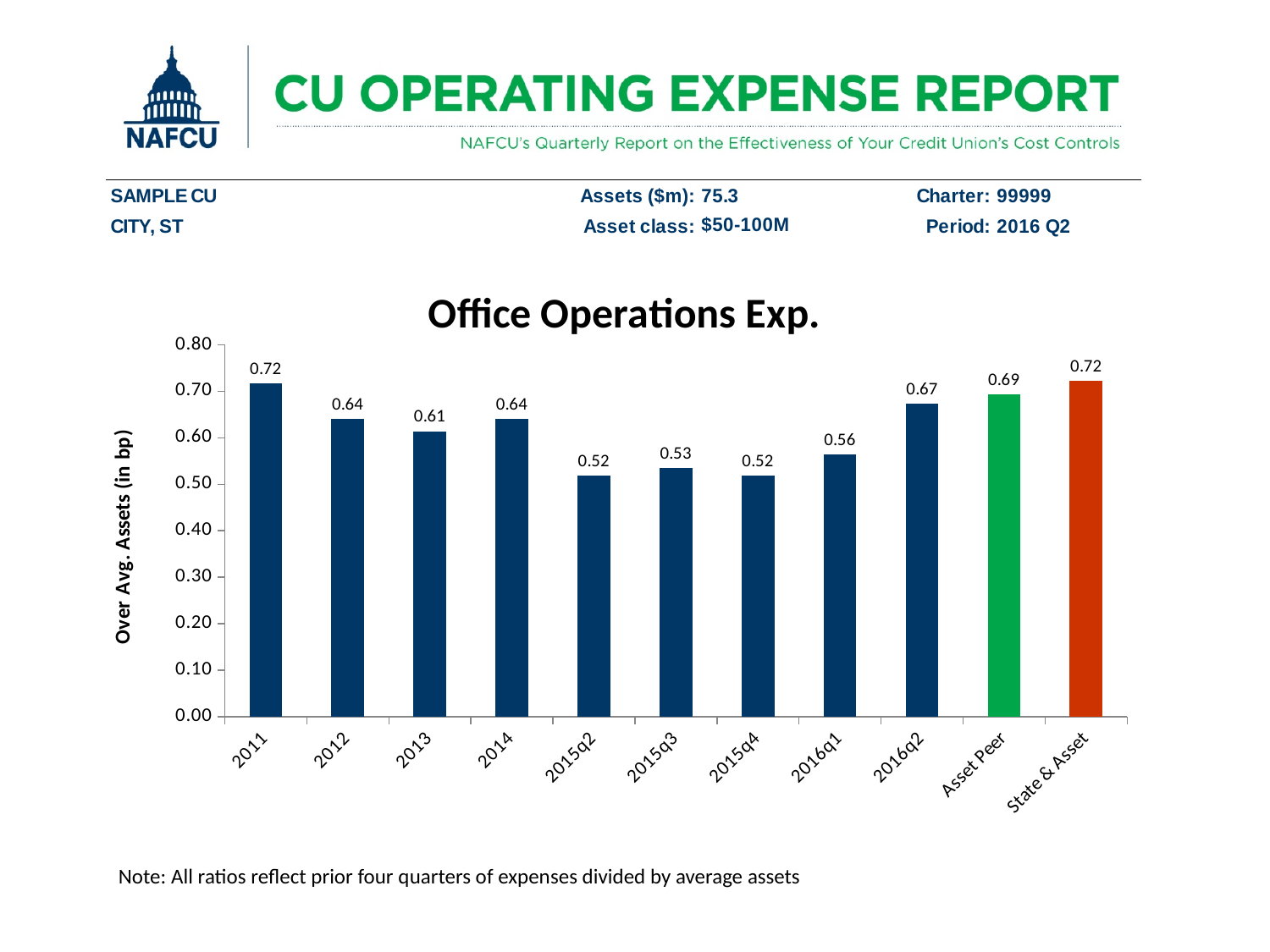
What kind of chart is the Office Operations Exp. chart? Bar chart What is the value for Asset Peer in the Office Operations Exp. chart? 0.69 Do the values in the Office Operations Exp. chart rise or fall from 2011 to 2015q2? Fall How many bars are shown in the Office Operations Exp. chart? 11 What is the lowest value shown in the Office Operations Exp. chart? 0.52 What is the difference between the values for 2016q2 and 2016q1 in the Office Operations Exp. chart? 0.11 What is the y-axis title of the Office Operations Exp. chart? Over Avg. Assets (in bp) What is the value for 2011 in the Office Operations Exp. chart? 0.72 Which is larger in the Office Operations Exp. chart, the value for Asset Peer or the value for 2016q2? Asset Peer What is the value for 2013 in the Office Operations Exp. chart? 0.61 What is the value for State & Asset in the Office Operations Exp. chart? 0.72 What is the value for 2016q2 in the Office Operations Exp. chart? 0.67